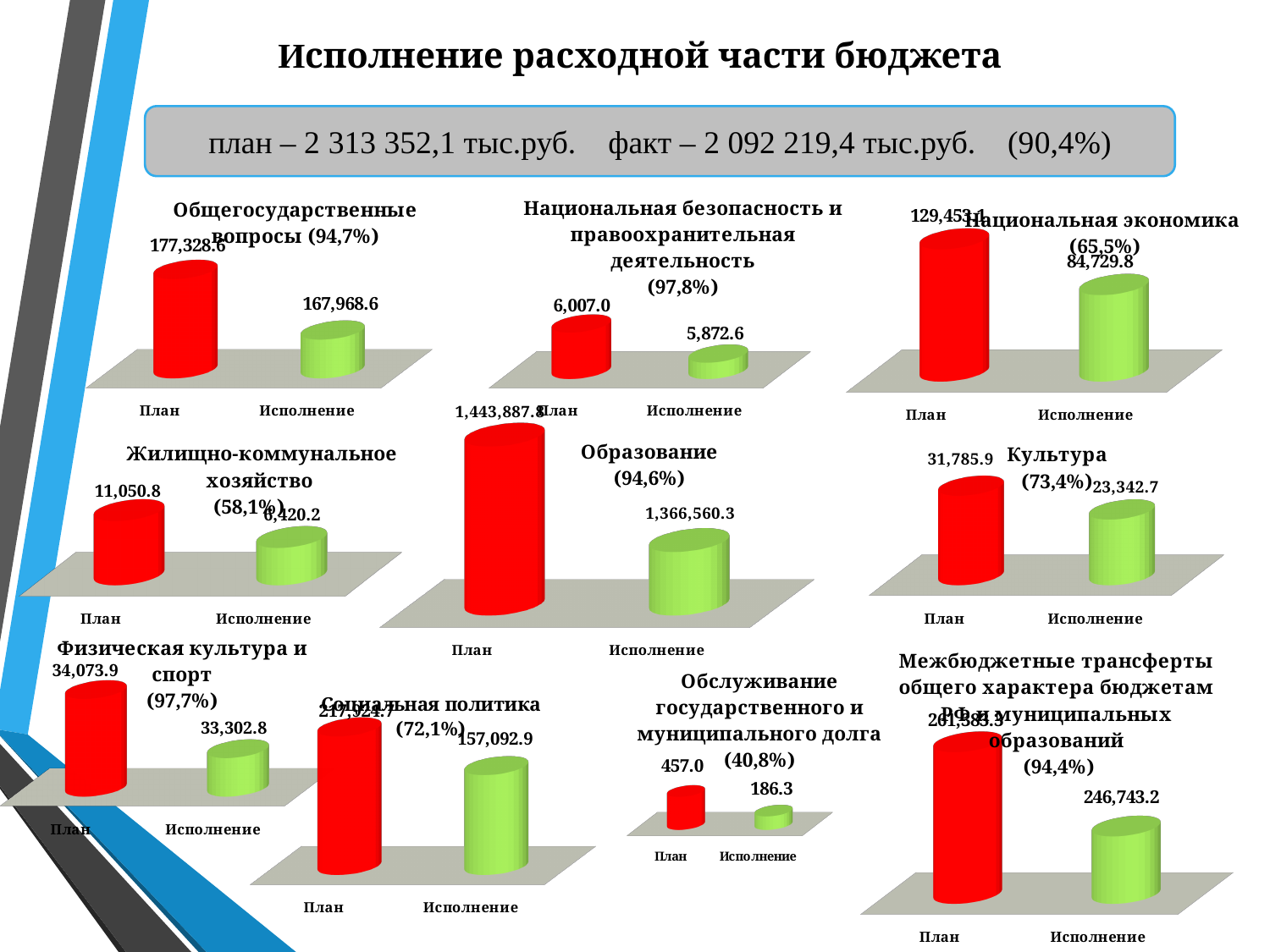
In the "Общегосударственные вопросы" chart, what is the value for Исполнение? 167,968.6 In the "Общегосударственные вопросы" chart, what is the value for План? 177,328.6 In the "Физическая культура и спорт" chart, which is larger, План or Исполнение? План In the "Национальная безопасность и правоохранительная деятельность" chart, what is the value for План? 6,007.0 In the "Национальная экономика" chart, what is the value for Исполнение? 84,729.8 In the "Обслуживание государственного и муниципального долга" chart, what is the value for План? 457.0 In the "Обслуживание государственного и муниципального долга" chart, what is the difference between План and Исполнение? 270.7 In the "Культура" chart, what is the difference between План and Исполнение? 8,443.2 How many categories does the "Жилищно-коммунальное хозяйство" chart show? 2 In the "Образование" chart, what is the value for Исполнение? 1,366,560.3 In the "Национальная безопасность и правоохранительная деятельность" chart, what is the value for Исполнение? 5,872.6 What kind of chart is the "Социальная политика" chart? Bar chart